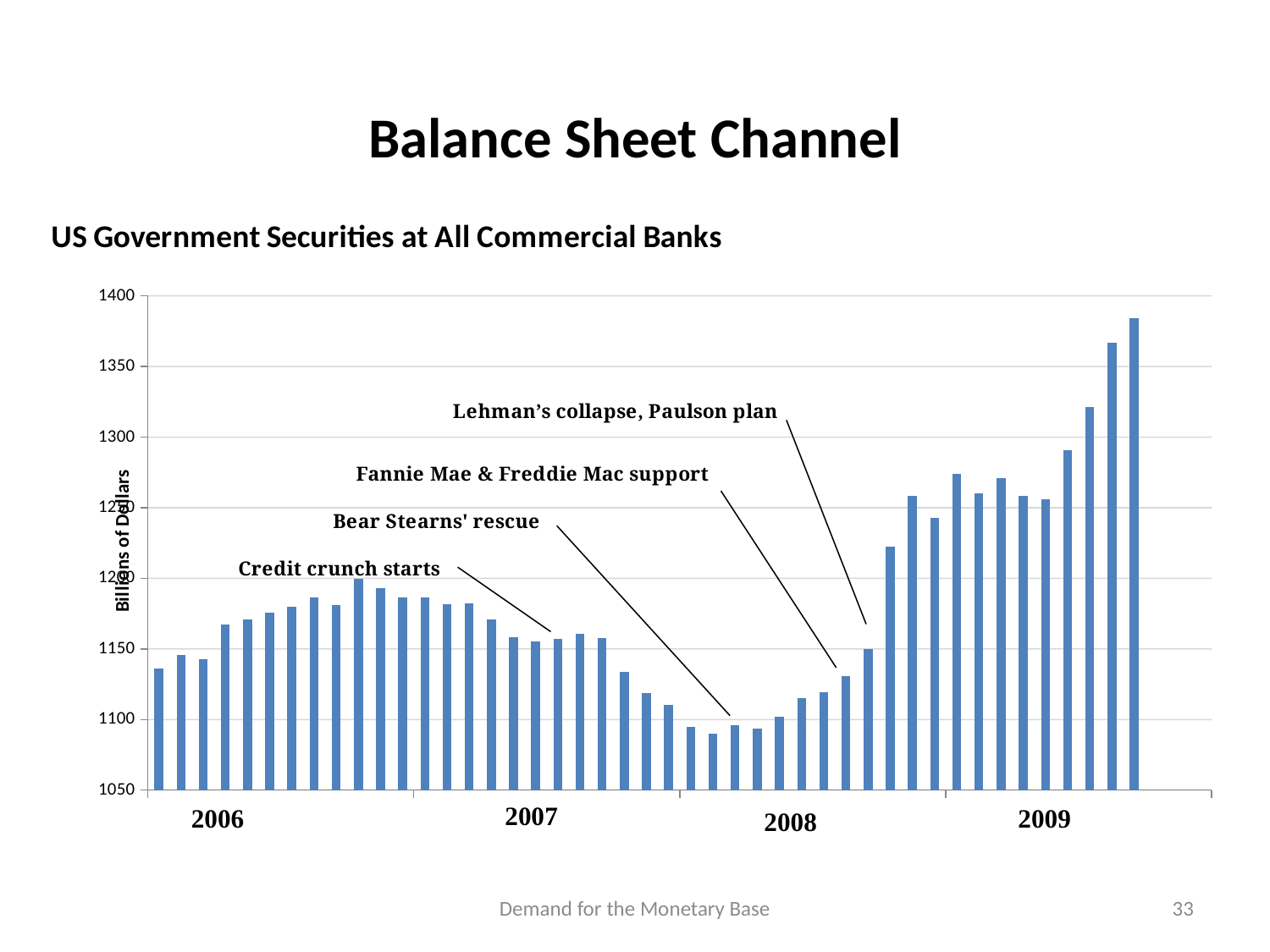
Which is larger: the first bar in 2006 or the last bar in 2009? the last bar in 2009 In which year does the shortest bar on the chart occur? 2008 Is the value of the shortest bar (in 2008) greater or less than 1100? less What is the label on the vertical axis of the chart? Billions of Dollars What kind of chart is shown on the slide? bar chart Is the value of the first bar in 2006 greater or less than 1150? less Do the values generally rise or fall across the bars after the 'Lehman's collapse, Paulson plan' annotation? rise In which year does the tallest bar on the chart occur? 2009 Is the value of the bar marked 'Fannie Mae & Freddie Mac support' greater or less than 1150? less What is the title of the chart? US Government Securities at All Commercial Banks Do the values generally rise or fall from the 'Credit crunch starts' bar to the 'Bear Stearns' rescue' bar? fall